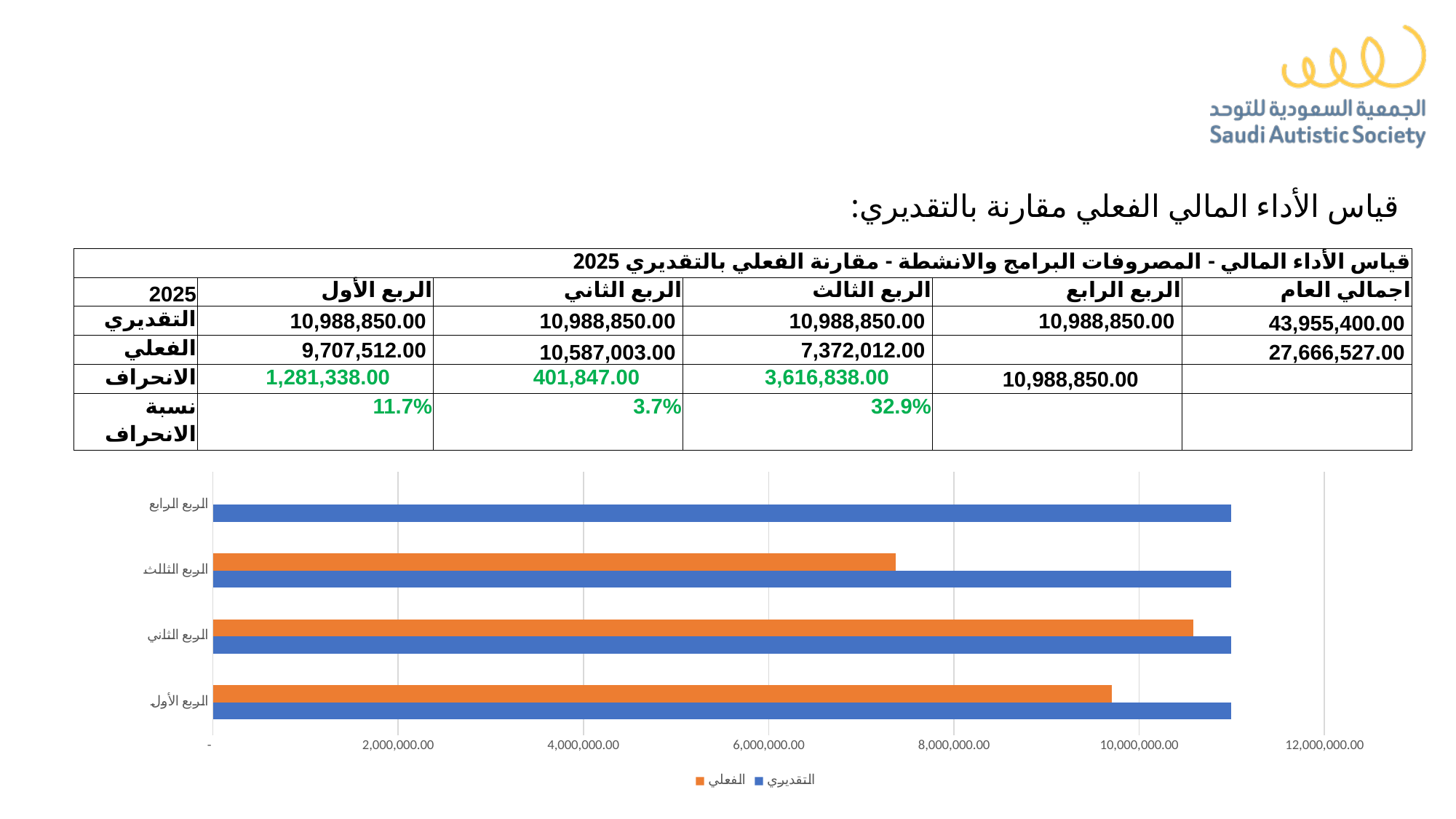
Is the الفعلي value for الربع الثالث greater or less than 8,000,000.00? less Is the التقديري value for الربع الأول greater or less than 10,000,000.00? greater What kind of chart is shown on the slide? bar chart What are the two series named in the chart legend? التقديري and الفعلي How many quarter categories are shown on the chart's vertical axis? 4 Is the الفعلي value for الربع الثاني greater or less than 10,000,000.00? greater Which has the larger الفعلي value, الربع الأول or الربع الثاني? الربع الثاني Which quarter on the chart has no الفعلي bar plotted? الربع الرابع According to the table, what is the الفعلي value for الربع الأول? 9,707,512.00 How many series does the chart legend list? 2 According to the table, what is the التقديري value for الربع الثاني? 10,988,850.00 Among the quarters with an الفعلي bar, which quarter has the lowest الفعلي value? الربع الثالث